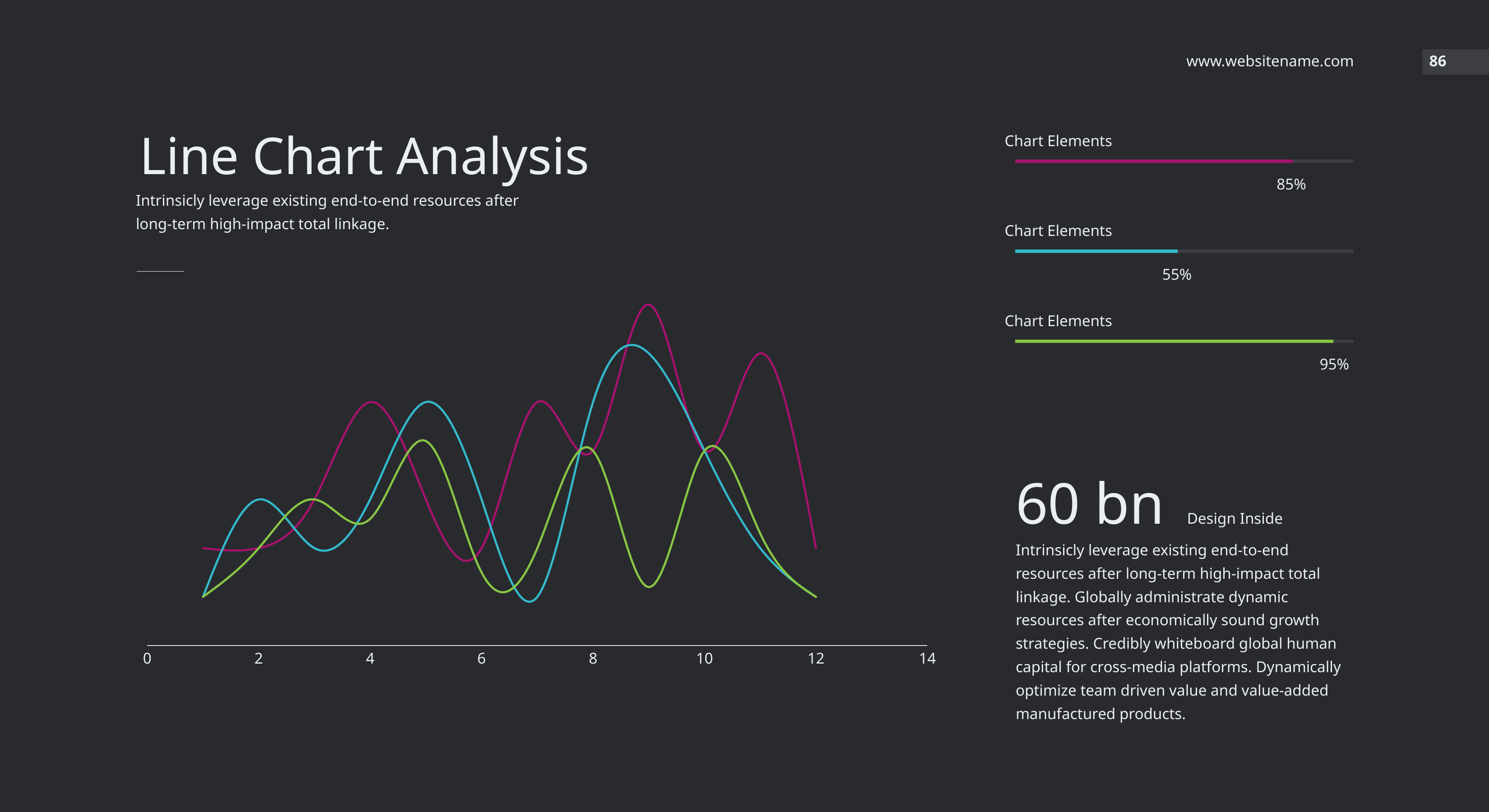
Which of the three 'Chart Elements' progress bars has the lowest percentage? the cyan one (55%) How many tick labels are shown on the x axis of the line chart? 8 What kind of chart is shown on the left of the slide? line chart What is the title of the slide containing the line chart? Line Chart Analysis How many lines are plotted on the line chart? 3 What percentage is shown for the green 'Chart Elements' progress bar? 95% Which coloured line reaches the highest point on the line chart? magenta What percentage is shown for the magenta 'Chart Elements' progress bar? 85% At x = 12, which coloured line on the line chart is highest? magenta What percentage is shown for the cyan 'Chart Elements' progress bar? 55% What is the difference between the green and cyan 'Chart Elements' percentages? 40% What is the highest value labelled on the x axis of the line chart? 14